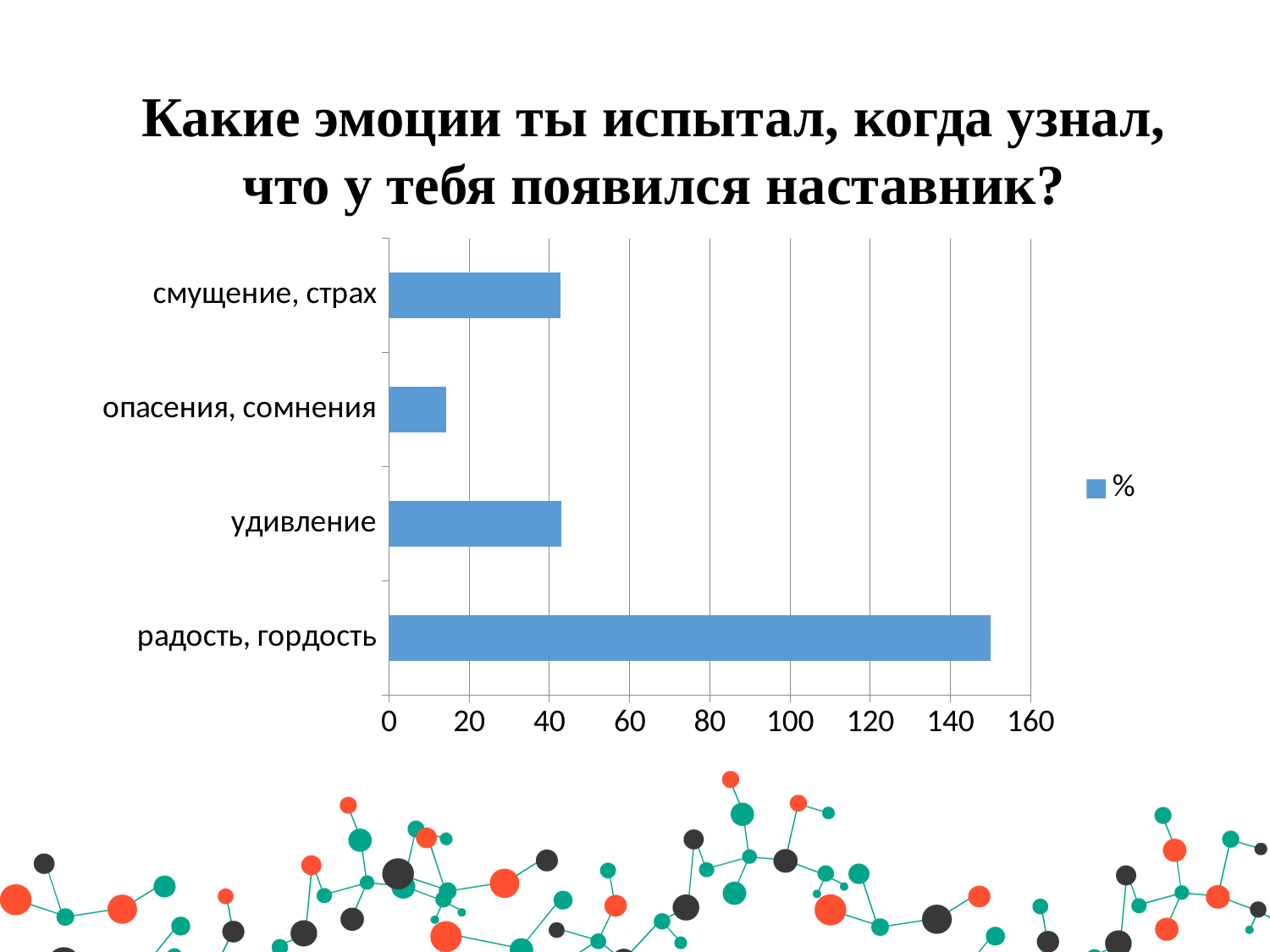
Is the value for смущение, страх greater or less than 20? greater Which category has the lowest value? опасения, сомнения What is the title of the slide above the chart? Какие эмоции ты испытал, когда узнал, что у тебя появился наставник? How many series does the legend list? 1 What is the legend entry for the series in the chart? % Which category has the highest value? радость, гордость Is the value for радость, гордость greater or less than 140? greater Is the value for удивление greater or less than 60? less How many categories are plotted in the chart? 4 Which is larger, the value for радость, гордость or the value for удивление? радость, гордость What kind of chart is shown on the slide? bar chart